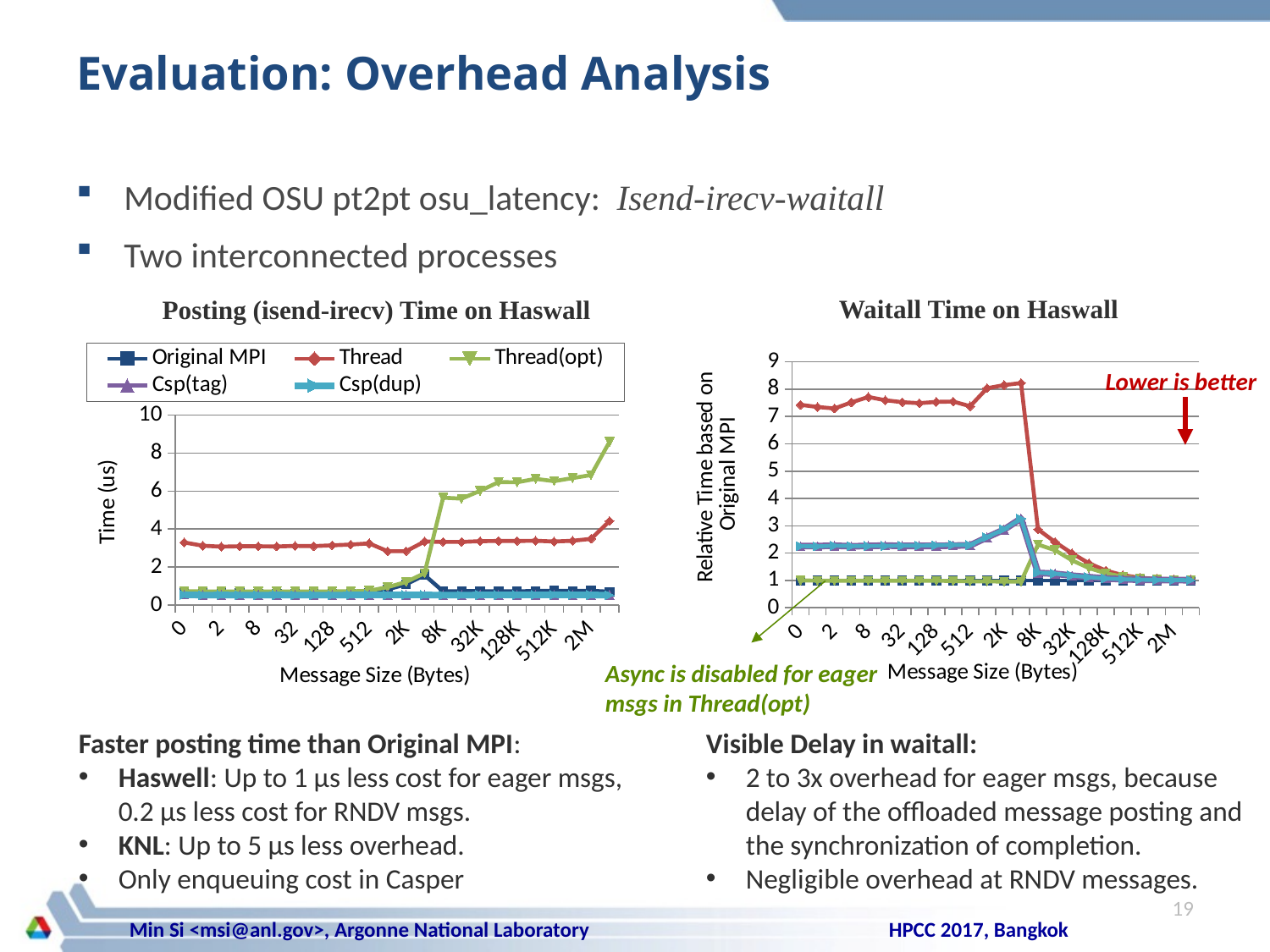
In the 'Posting (isend-irecv) Time on Haswall' chart, is the value for Thread(opt) at 2M greater or less than 8? less How many series does the legend list for the charts on this slide? 5 What is the y-axis label of the 'Waitall Time on Haswall' chart? Relative Time based on Original MPI What is the x-axis label of the 'Posting (isend-irecv) Time on Haswall' chart? Message Size (Bytes) How many message-size tick labels are shown on the x axis of the 'Posting (isend-irecv) Time on Haswall' chart? 12 In the 'Waitall Time on Haswall' chart, does the Thread series rise or fall from 8K to 2M? fall What kind of chart is the 'Posting (isend-irecv) Time on Haswall' chart? line chart In the 'Posting (isend-irecv) Time on Haswall' chart, which series has the highest value at message size 2M? Thread(opt) In the 'Waitall Time on Haswall' chart, is the value for Thread at message size 0 greater or less than 6? greater In the 'Waitall Time on Haswall' chart, which series has the highest value at message size 0? Thread In the 'Posting (isend-irecv) Time on Haswall' chart, is the value for Thread at message size 0 greater or less than 2? greater